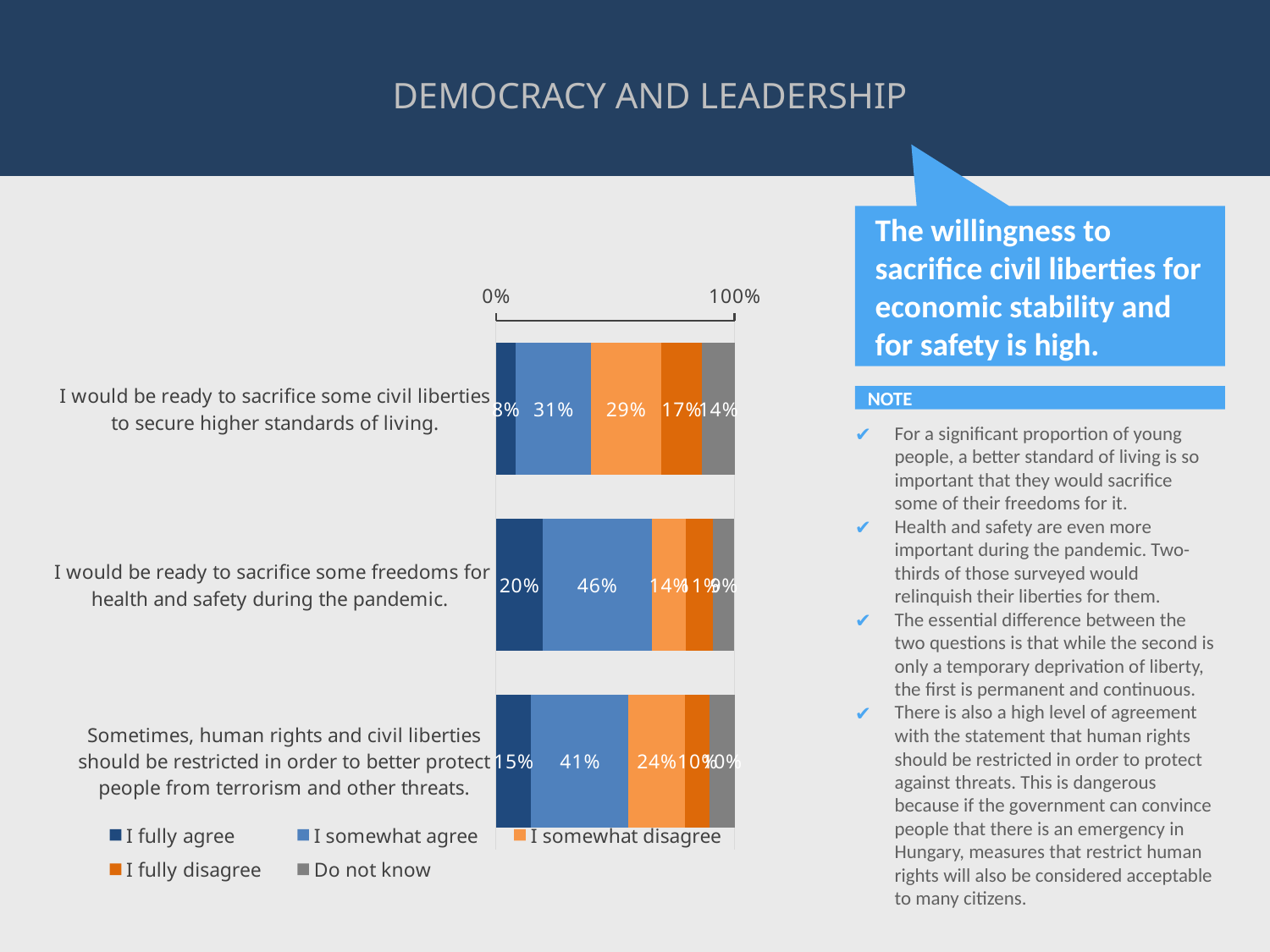
What percentage fully agree that they would be ready to sacrifice some freedoms for health and safety during the pandemic? 20% Which statement has the highest share of 'I somewhat agree' responses? I would be ready to sacrifice some freedoms for health and safety during the pandemic. What percentage somewhat agree that human rights and civil liberties should sometimes be restricted to better protect people from terrorism and other threats? 41% What percentage somewhat disagree that they would be ready to sacrifice some civil liberties to secure higher standards of living? 29% What kind of chart is shown on the slide? Stacked bar chart How many statements (categories) are plotted in the chart? 3 What percentage somewhat agree that they would be ready to sacrifice some civil liberties to secure higher standards of living? 31% What percentage of respondents somewhat agree that they would be ready to sacrifice some freedoms for health and safety during the pandemic? 46% Which statement has a larger 'I fully agree' share: the one about health and safety during the pandemic or the one about terrorism and other threats? Health and safety during the pandemic How many series does the legend list? 5 What is the difference in 'I somewhat agree' share between the pandemic statement (46%) and the higher standards of living statement (31%)? 15 percentage points Which legend entry is shown in grey? Do not know